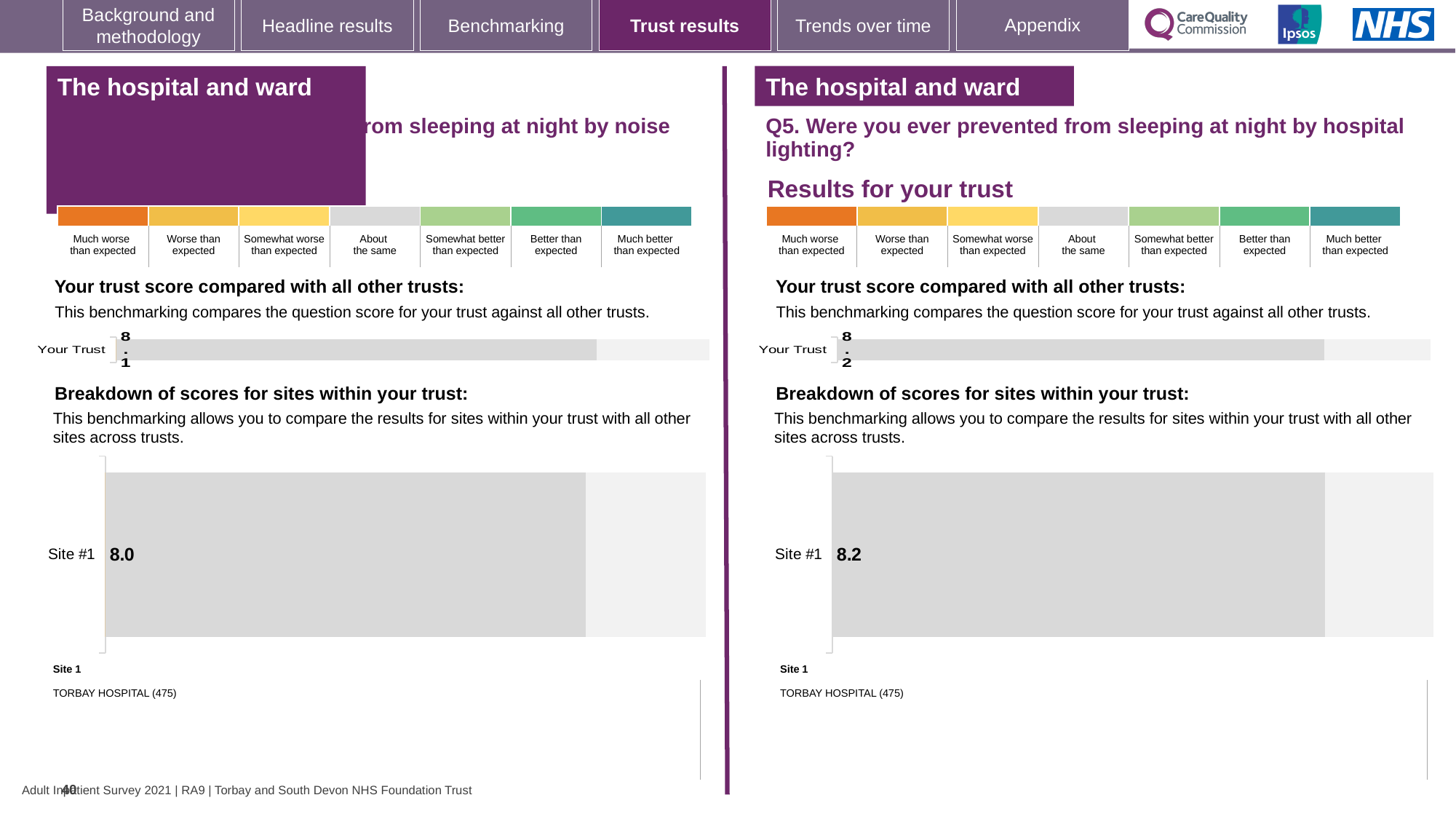
On the right half of the slide (Q5, hospital lighting), in the 'Breakdown of scores for sites within your trust' chart, what is the score for Site #1? 8.2 On the left half of the slide, what is the difference between the Your Trust score and the Site #1 score? 0.1 On the right half of the slide (Q5, hospital lighting), in the 'Your trust score compared with all other trusts' chart, what is the score for Your Trust? 8.2 On the left half of the slide, how many sites are shown in the 'Breakdown of scores for sites within your trust' chart? 1 On the left half of the slide, in the 'Breakdown of scores for sites within your trust' chart, what is the score for Site #1? 8.0 What kind of chart is used for the 'Breakdown of scores for sites within your trust' on the right half of the slide? bar chart On the left half of the slide, which is larger: the Your Trust score or the Site #1 score? Your Trust Which half of the slide shows the higher Site #1 score, the left (noise) or the right (hospital lighting)? right (hospital lighting) On the left half of the slide, what number is shown in brackets after TORBAY HOSPITAL under Site 1? 475 What is the difference between the Site #1 score on the right half of the slide and the Site #1 score on the left half? 0.2 On the right half of the slide, which hospital is listed as Site 1 below the breakdown chart? TORBAY HOSPITAL (475) On the left half of the slide, in the 'Your trust score compared with all other trusts' chart, what is the score for Your Trust? 8.1